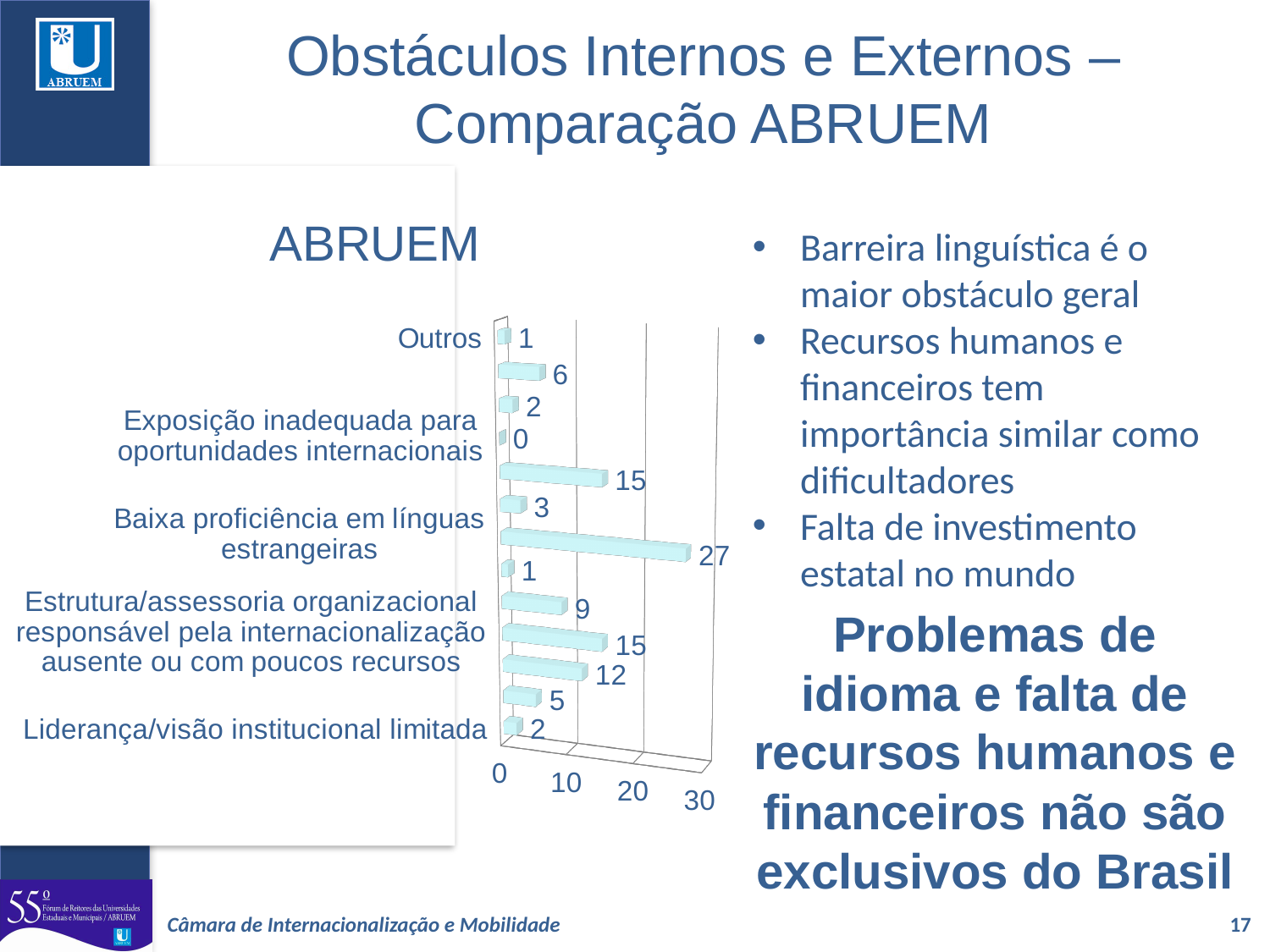
What is the value for 'Exposição inadequada para oportunidades internacionais'? 0 What is the difference between the value for 'Baixa proficiência em línguas estrangeiras' and the value for 'Estrutura/assessoria organizacional responsável pela internacionalização ausente ou com poucos recursos'? 12 Which category has the highest value? Baixa proficiência em línguas estrangeiras What is the value for 'Liderança/visão institucional limitada'? 2 What is the title of the chart? ABRUEM What is the value for 'Outros'? 1 What is the lowest value shown in the chart? 0 What is the value for 'Baixa proficiência em línguas estrangeiras'? 27 Which is larger, the value for 'Outros' or the value for 'Liderança/visão institucional limitada'? Liderança/visão institucional limitada What is the highest value shown in the chart? 27 What type of chart is shown on the slide? bar chart How many bars (categories) does the chart show? 13